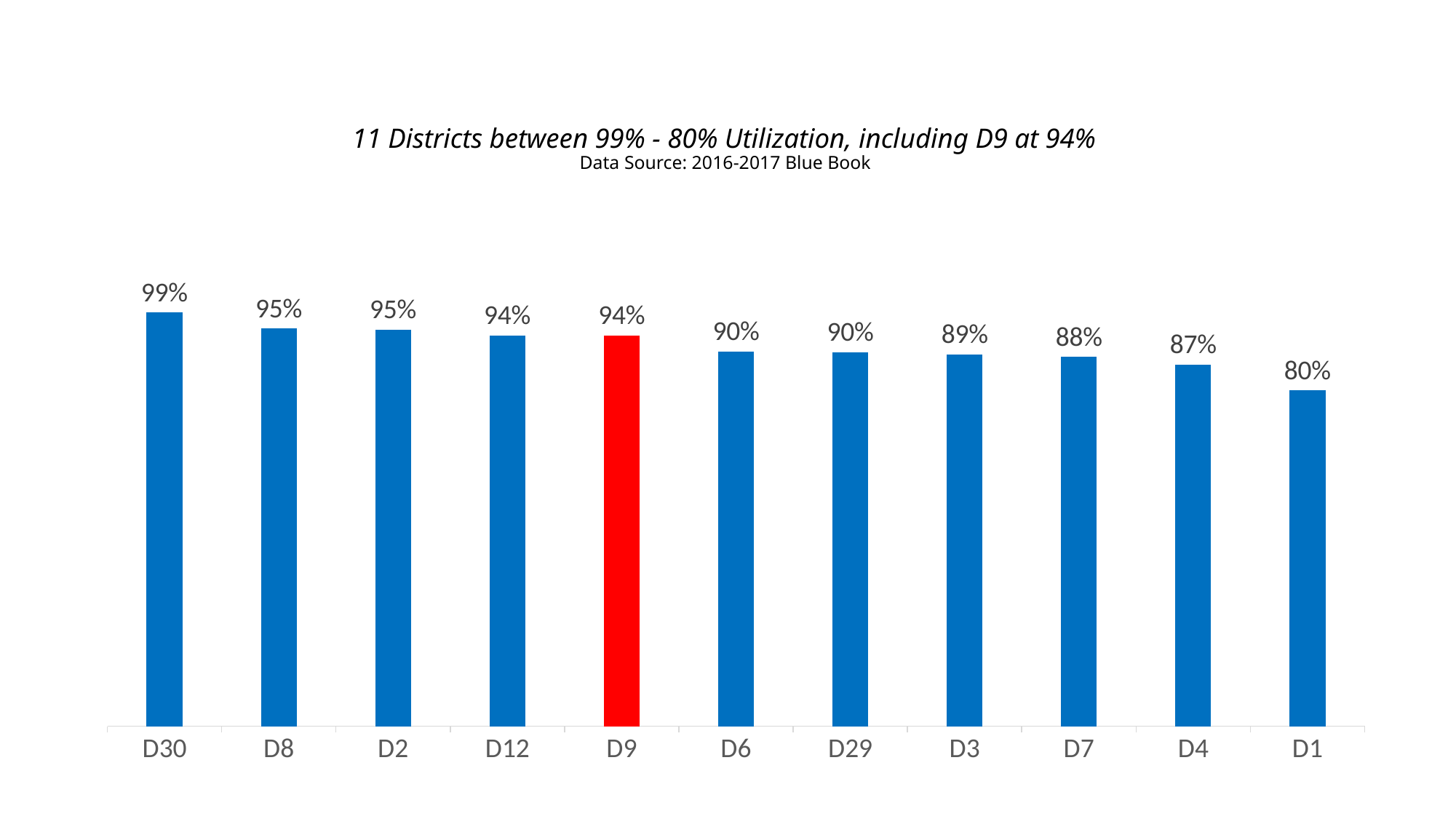
What kind of chart is shown on the slide? Bar chart What is the utilization value for D9? 94% Which district's bar is coloured red? D9 Which has a higher utilization, D2 or D3? D2 Do the values rise or fall from left to right along the x axis? Fall How many districts are shown in the chart? 11 Which district has the highest utilization? D30 What is the utilization value for D30? 99% What is the difference between the utilization of D8 and D4? 8% What is the difference between the utilization of D30 and D1? 19% What is the utilization value for D7? 88% Which district has the lowest utilization? D1